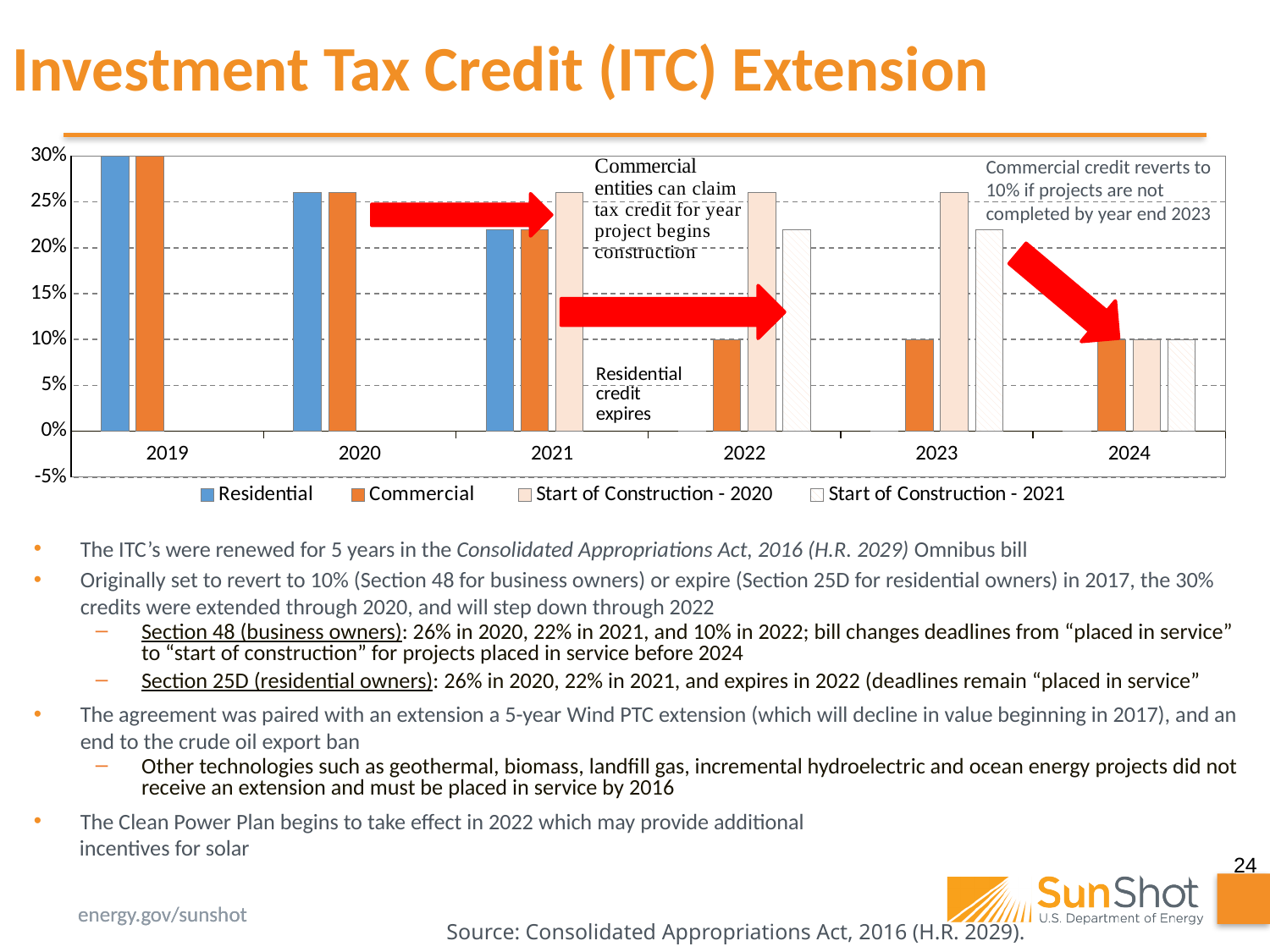
Which is larger, the Commercial value for 2019 or the Commercial value for 2022? 2019 What is the Residential value for 2019? 30% How many years are shown on the x axis of the chart? 6 In which years does the Residential series have bars? 2019, 2020, 2021 What is the Start of Construction - 2020 value for 2024? 10% What is the Commercial value for 2022? 10% Is the Residential value for 2021 greater or less than 20%? greater What kind of chart is shown on the slide? Bar chart Is the Start of Construction - 2020 value for 2023 greater or less than 30%? less What is the difference between the Commercial value for 2019 and the Commercial value for 2022? 20% Do the Commercial values rise or fall from 2019 to 2024? Fall How many series does the chart legend list? 4